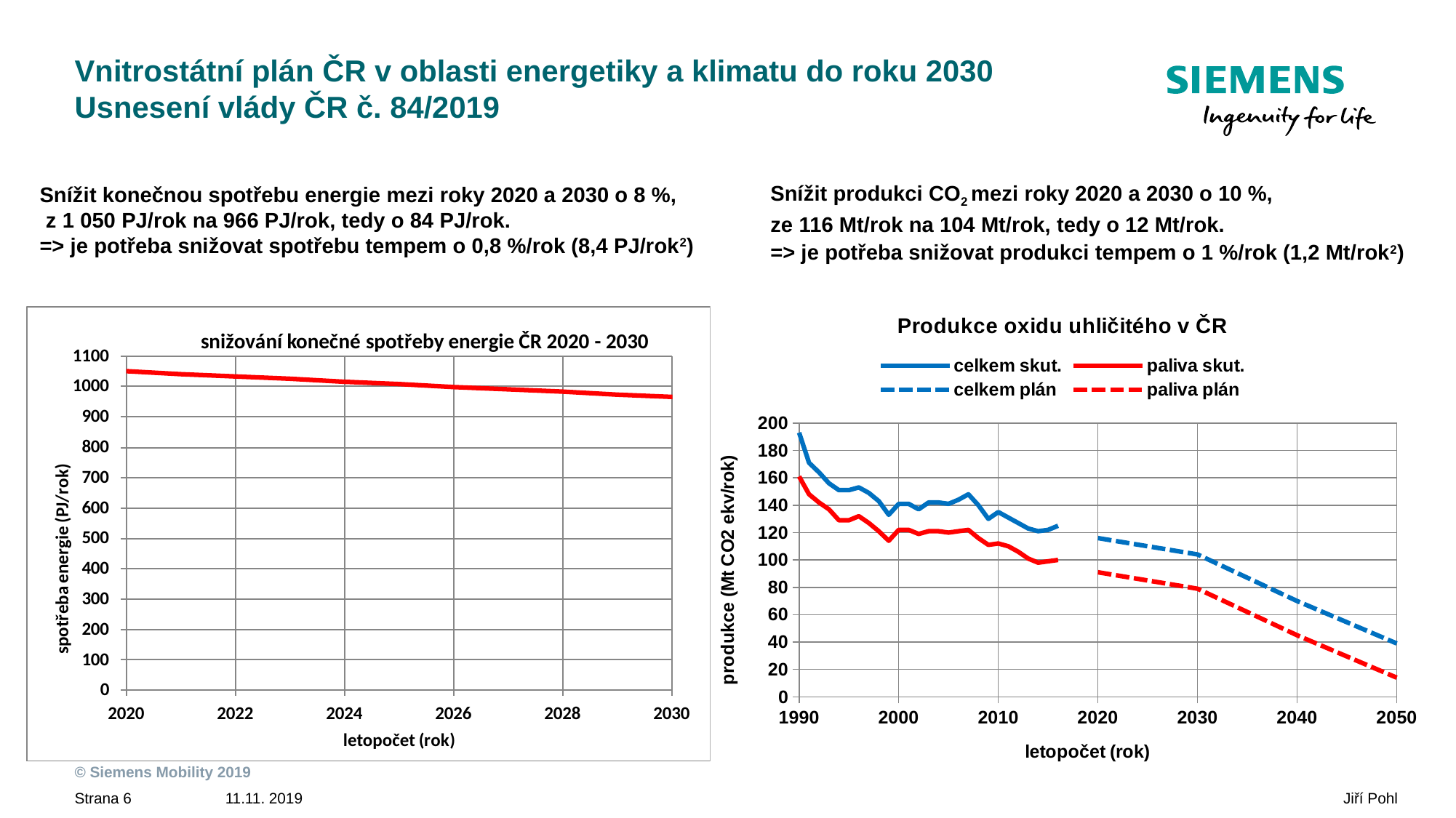
In the right chart 'Produkce oxidu uhličitého v ČR', which series is higher in 2000, 'celkem skut.' or 'paliva skut.'? celkem skut. How many series does the legend of the right chart 'Produkce oxidu uhličitého v ČR' list? 4 In the right chart 'Produkce oxidu uhličitého v ČR', which series has the highest value in 1990? celkem skut. In the left chart 'snižování konečné spotřeby energie ČR 2020 - 2030', what is the y-axis label? spotřeba energie (PJ/rok) In the right chart 'Produkce oxidu uhličitého v ČR', is the value of 'celkem skut.' in 1990 greater or less than 180? greater In the right chart 'Produkce oxidu uhličitého v ČR', does the 'celkem skut.' series rise or fall overall from 1990 to 2016? fall In the left chart 'snižování konečné spotřeby energie ČR 2020 - 2030', does the value rise or fall from 2020 to 2030? fall What kind of chart is the right chart 'Produkce oxidu uhličitého v ČR'? line chart What kind of chart is the left chart titled 'snižování konečné spotřeby energie ČR 2020 - 2030'? line chart In the right chart 'Produkce oxidu uhličitého v ČR', is the value of 'paliva plán' in 2050 greater or less than 20? less In the left chart 'snižování konečné spotřeby energie ČR 2020 - 2030', is the value for 2030 greater or less than 1000? less